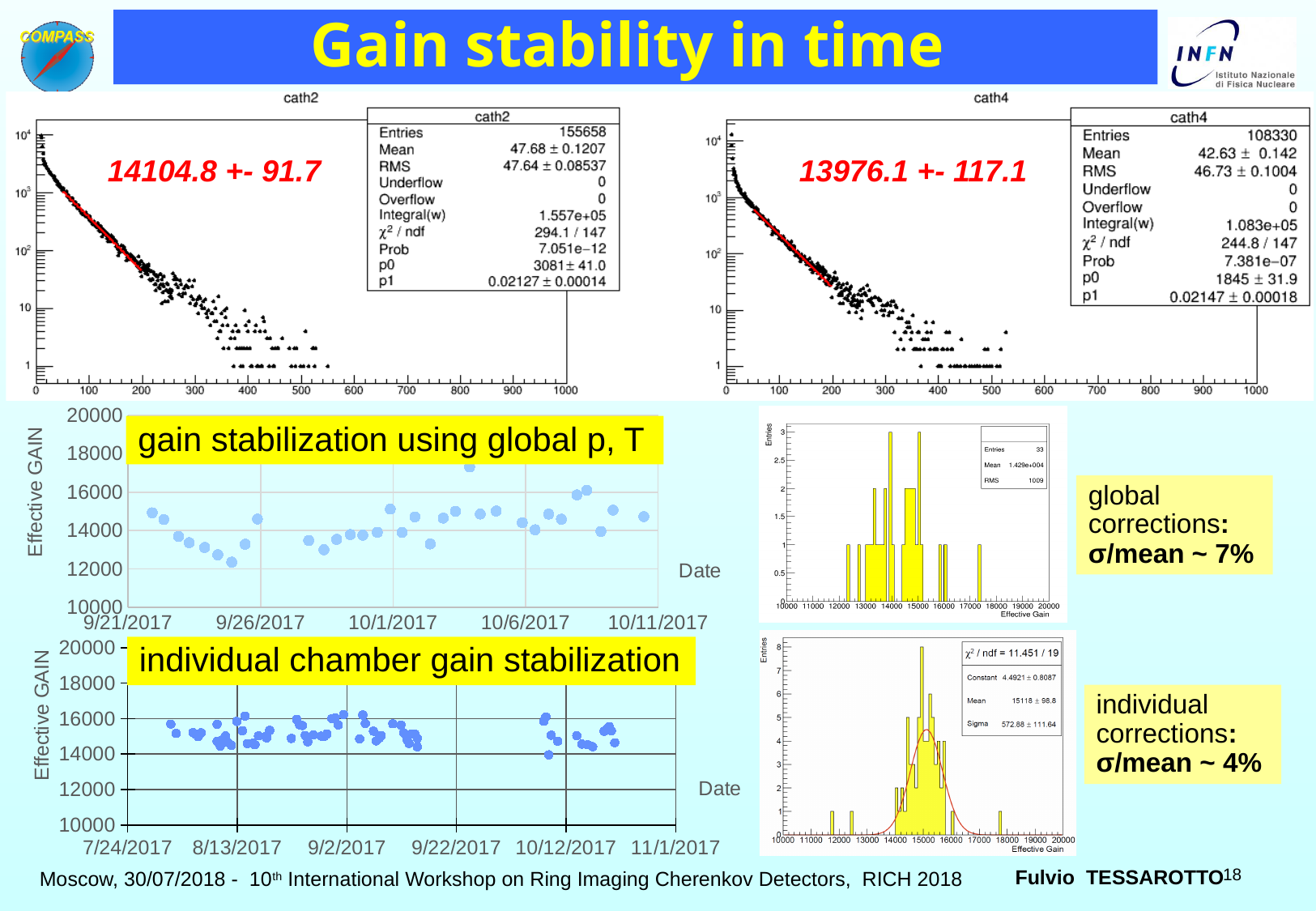
What is the red fitted value annotated on the cath4 chart? 13976.1 +- 117.1 In the 'gain stabilization using global p, T' chart, is the lowest Effective GAIN point greater or less than 14000? less In the cath4 chart, what is the value of p0 in the statistics box? 1845 ± 31.9 In the cath2 chart at the top left, how many entries are listed in the statistics box? 155658 Which of the two top charts, cath2 or cath4, has more entries? cath2 What kind of chart is the 'gain stabilization using global p, T' plot on the lower left? scatter plot In the lower yellow histogram on the right, what is the fitted Mean shown in the statistics box? 15118 ± 98.8 In the 'gain stabilization using global p, T' chart, is the highest Effective GAIN point greater or less than 16000? greater In the cath4 chart at the top right, how many entries are listed in the statistics box? 108330 What is the red fitted value annotated on the cath2 chart? 14104.8 +- 91.7 In the upper yellow histogram on the right, how many entries are listed in the statistics box? 33 What is the difference in entries between the cath2 chart and the cath4 chart? 47328